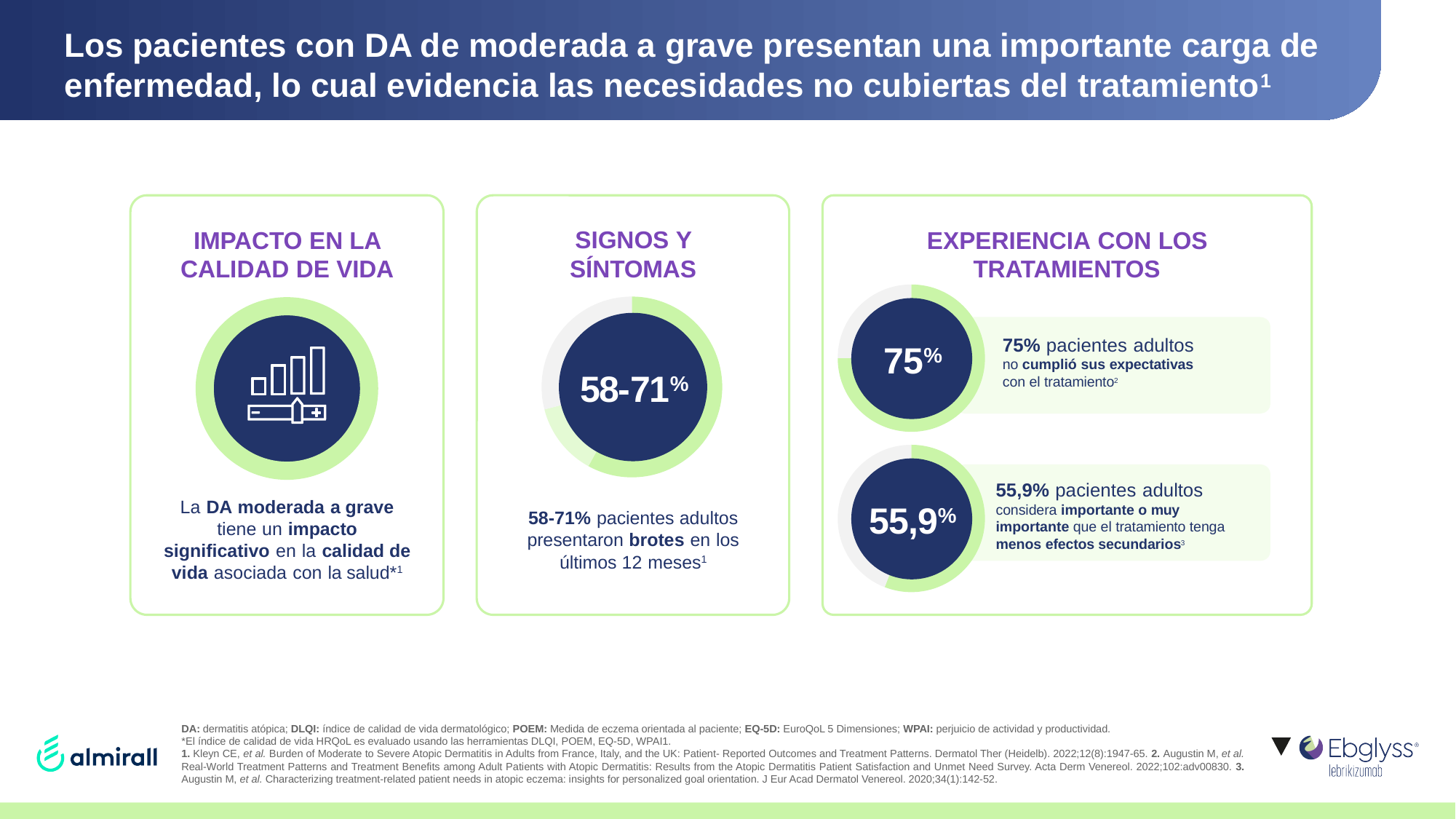
How many ring charts are shown in the 'EXPERIENCIA CON LOS TRATAMIENTOS' panel? 2 In the 'SIGNOS Y SÍNTOMAS' panel, what value is shown in the centre of the ring chart? 58-71% What colour is the filled portion of the rings around the percentage circles? Green In the 'EXPERIENCIA CON LOS TRATAMIENTOS' panel, which ring chart shows the larger value: the one about unmet expectations or the one about fewer side effects? Unmet expectations (75%) In the 'EXPERIENCIA CON LOS TRATAMIENTOS' panel, what percentage of adult patients did not meet their expectations with treatment? 75% In the 'EXPERIENCIA CON LOS TRATAMIENTOS' panel, what percentage of adult patients consider it important or very important that treatment has fewer side effects? 55,9% How many ring charts with a printed percentage are shown on the slide in total? 3 What is the title of the panel containing the 58-71% ring chart? SIGNOS Y SÍNTOMAS What kind of chart is used to display the 75% value? Ring (donut) chart In the 'EXPERIENCIA CON LOS TRATAMIENTOS' panel, what is the difference between the two ring chart values, 75% and 55,9%? 19,1% Among the three ring charts on the slide, which shows the lowest value? 55,9%